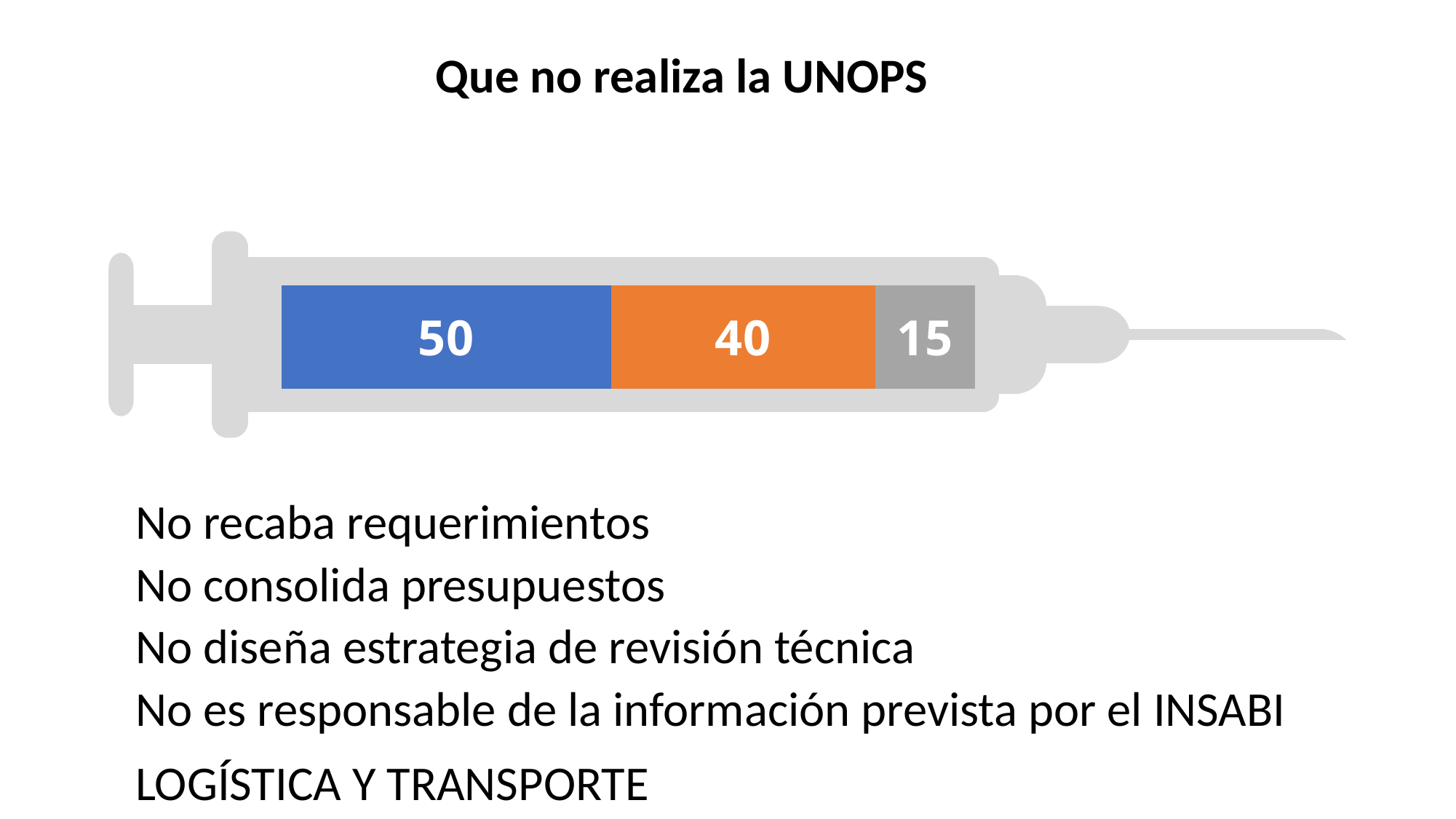
What is the value shown on the blue segment of the stacked bar? 50 Which segment of the stacked bar has the highest value? The blue segment (50) What kind of chart is shown on the slide? A stacked bar chart How many segments does the stacked bar contain? 3 Which is larger, the orange segment value or the grey segment value? The orange segment (40) What is the difference between the orange segment value and the grey segment value? 25 What is the title shown above the chart? Que no realiza la UNOPS Which segment of the stacked bar has the lowest value? The grey segment (15) What is the total of all segments in the stacked bar? 105 What is the value shown on the orange segment of the stacked bar? 40 What is the value shown on the grey segment of the stacked bar? 15 What is the difference between the blue segment value and the orange segment value? 10